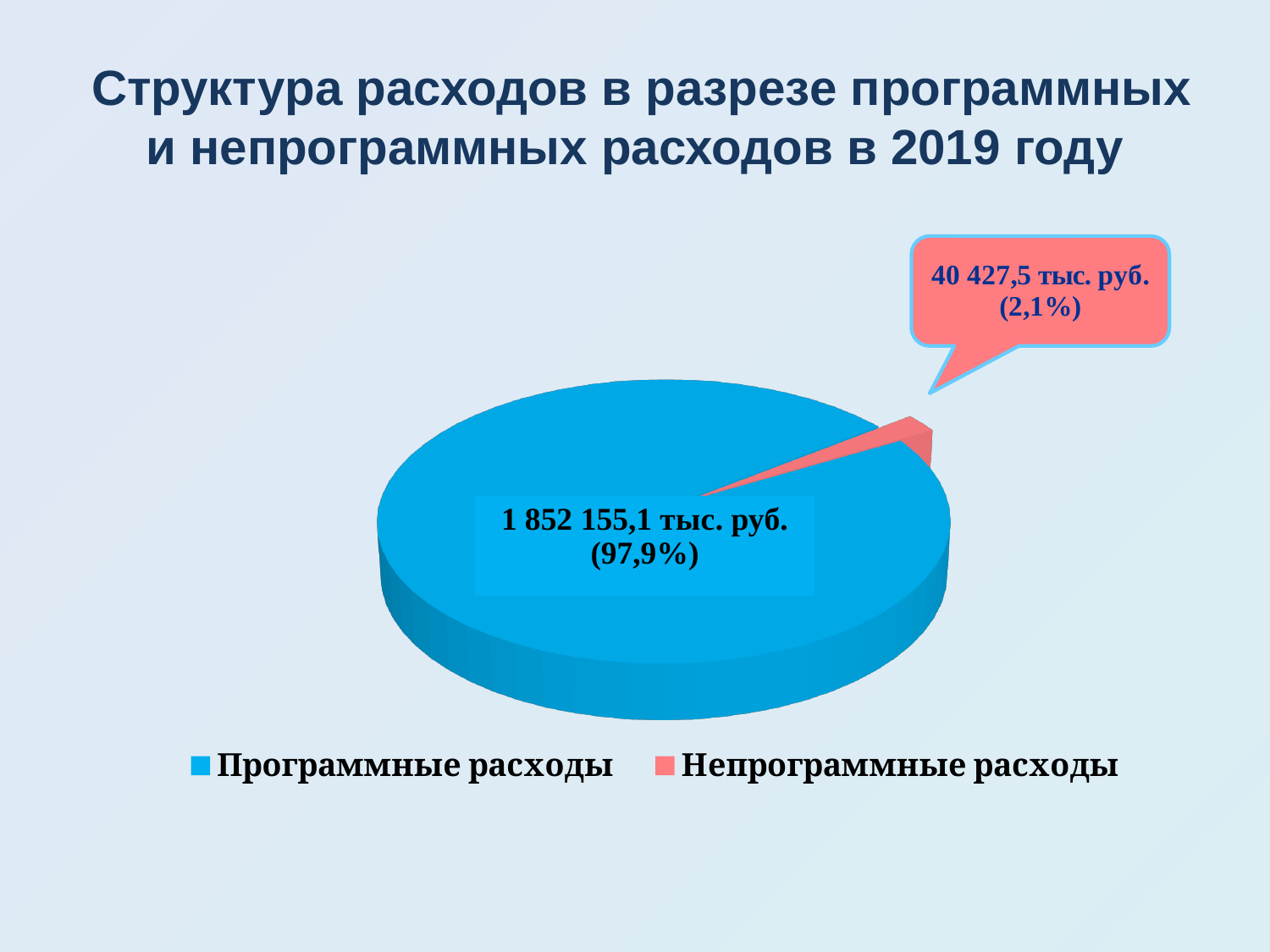
What is the value for Программные расходы? 1 852 155,1 тыс. руб. What kind of chart is shown on the slide? pie chart What is the title of the slide? Структура расходов в разрезе программных и непрограммных расходов в 2019 году What is the value for Непрограммные расходы? 40 427,5 тыс. руб. What share of the pie does Программные расходы represent? 97,9% How many categories does the pie chart have? 2 Which category has the smallest slice of the pie? Непрограммные расходы Which category has the largest slice of the pie? Программные расходы Which is larger, Программные расходы or Непрограммные расходы? Программные расходы How many entries does the legend list? 2 What colour is the slice for Непрограммные расходы? red (pink) What share of the pie does Непрограммные расходы represent? 2,1%